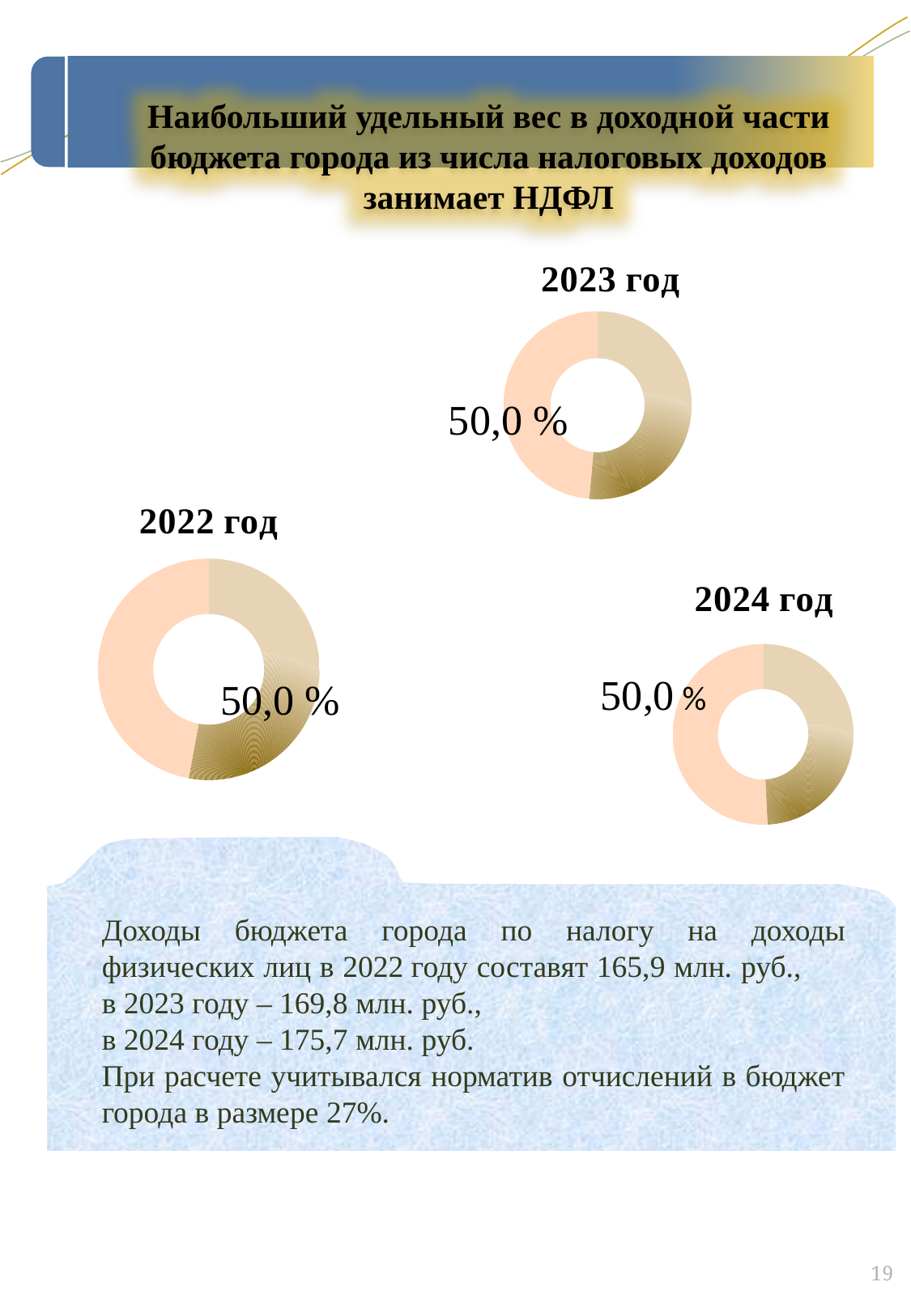
What kind of chart is the one titled "2022 год"? doughnut chart How many slices does the chart titled "2022 год" have? 2 In the chart titled "2022 год", what percentage value is printed as a data label? 50,0 % Is the labelled share in the chart titled "2024 год" greater or less than 40%? greater How many slices does the chart titled "2023 год" have? 2 What kind of chart is the one titled "2024 год"? doughnut chart Is the labelled share in the chart titled "2022 год" greater or less than 60%? less In the chart titled "2024 год", what percentage value is printed as a data label? 50,0 % How many doughnut charts are shown on the slide? 3 What is the title of the chart positioned at the top of the slide? 2023 год In the chart titled "2023 год", what percentage value is printed as a data label? 50,0 % What is the title of the chart positioned at the bottom right of the slide? 2024 год